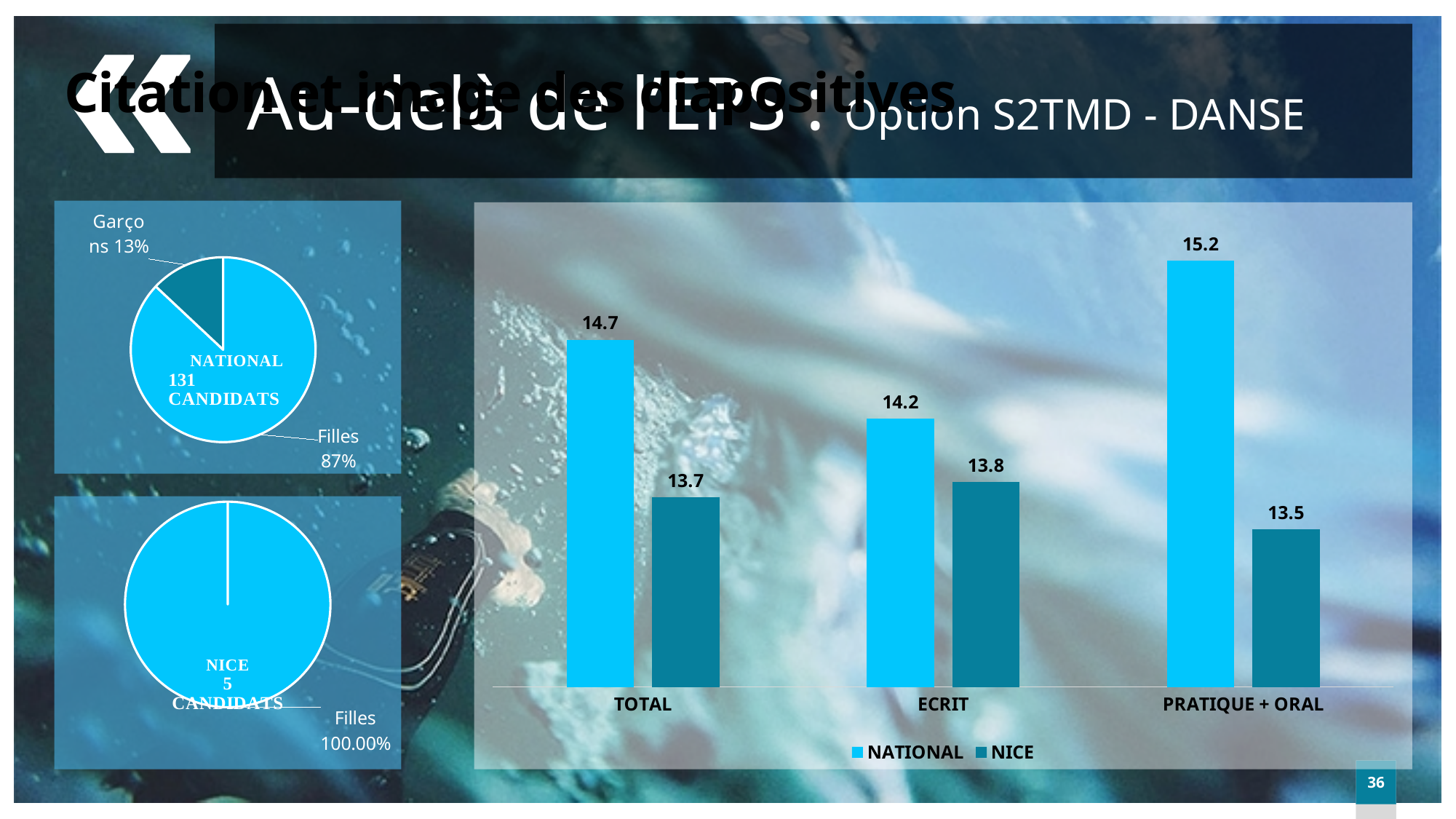
In the bottom-left pie chart (NICE 5 CANDIDATS), what share is Filles? 100.00% In the bar chart on the right, what is the difference between the NATIONAL and NICE values for TOTAL? 1.0 In the bar chart on the right, what is the NICE value for ECRIT? 13.8 How many series does the legend of the bar chart on the right list? 2 In the bar chart on the right, what is the NATIONAL value for PRATIQUE + ORAL? 15.2 In the bar chart on the right, which category has the highest NATIONAL value? PRATIQUE + ORAL In the bar chart on the right, what is the NATIONAL value for TOTAL? 14.7 In the bar chart on the right, what is the NICE value for PRATIQUE + ORAL? 13.5 How many categories are shown on the x axis of the bar chart on the right? 3 In the bar chart on the right, which category has the lowest NICE value? PRATIQUE + ORAL In the top-left pie chart (NATIONAL 131 CANDIDATS), what share is Filles? 87% In the bar chart on the right, which is larger for ECRIT: NATIONAL or NICE? NATIONAL